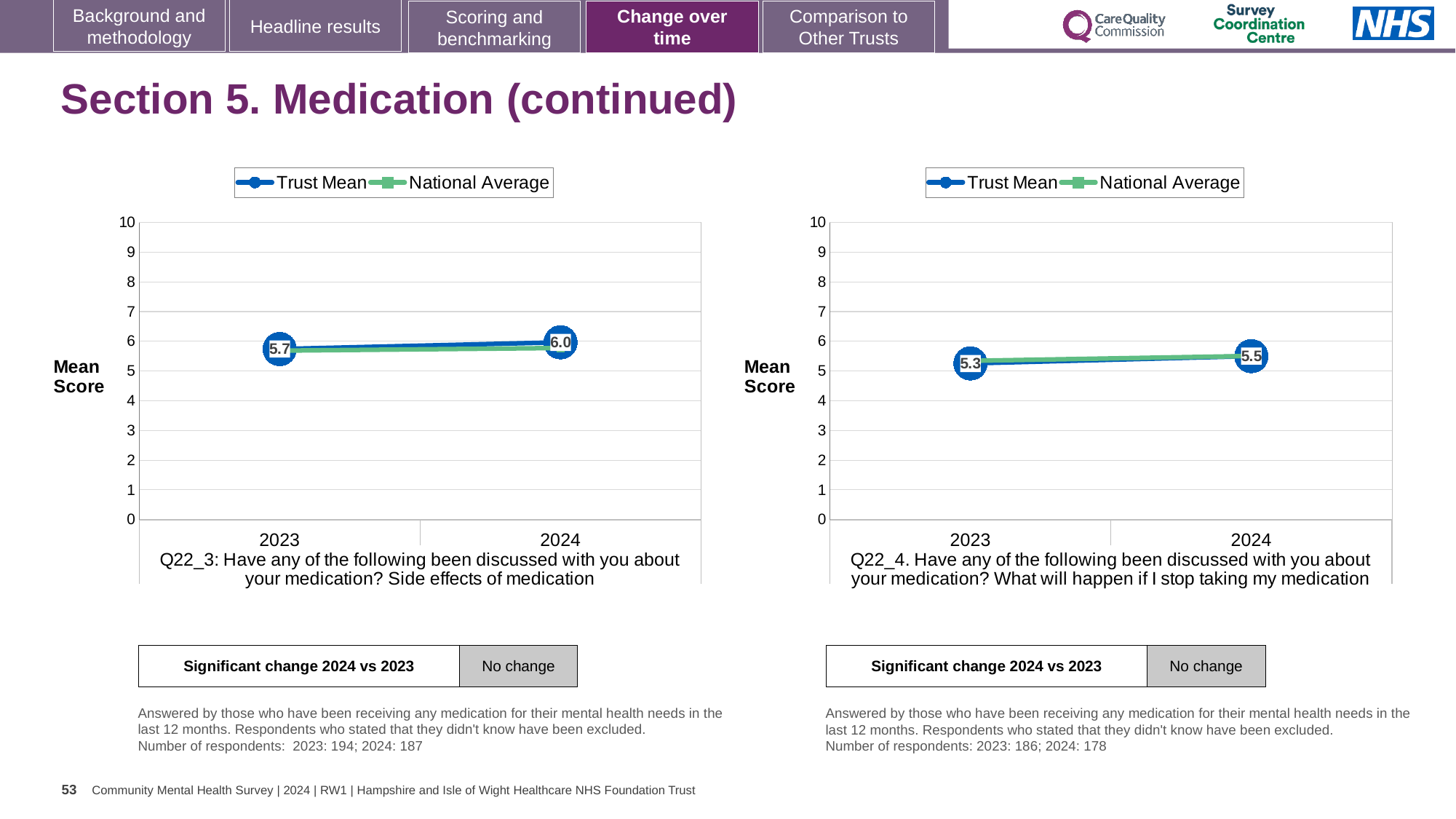
How many series does the legend of the left chart list? 2 Which chart has the higher Trust Mean for 2024, the left chart (Q22_3) or the right chart (Q22_4)? the left chart (Q22_3) In the right chart (Q22_4), by how much did the Trust Mean change from 2023 to 2024? 0.2 In the left chart (Q22_3), does the Trust Mean rise or fall from 2023 to 2024? rise How many years are plotted on the x axis of the right chart (Q22_4)? 2 In the right chart (Q22_4), what is the Trust Mean for 2024? 5.5 In the right chart (Q22_4), is the Trust Mean for 2024 greater or less than 6? less In the left chart (Q22_3), what is the Trust Mean for 2023? 5.7 In the right chart (Q22_4), what is the Trust Mean for 2023? 5.3 What kind of chart is the left chart (Q22_3)? line chart In the left chart (Q22_3), what is the Trust Mean for 2024? 6.0 In the left chart (Q22_3), by how much did the Trust Mean change from 2023 to 2024? 0.3